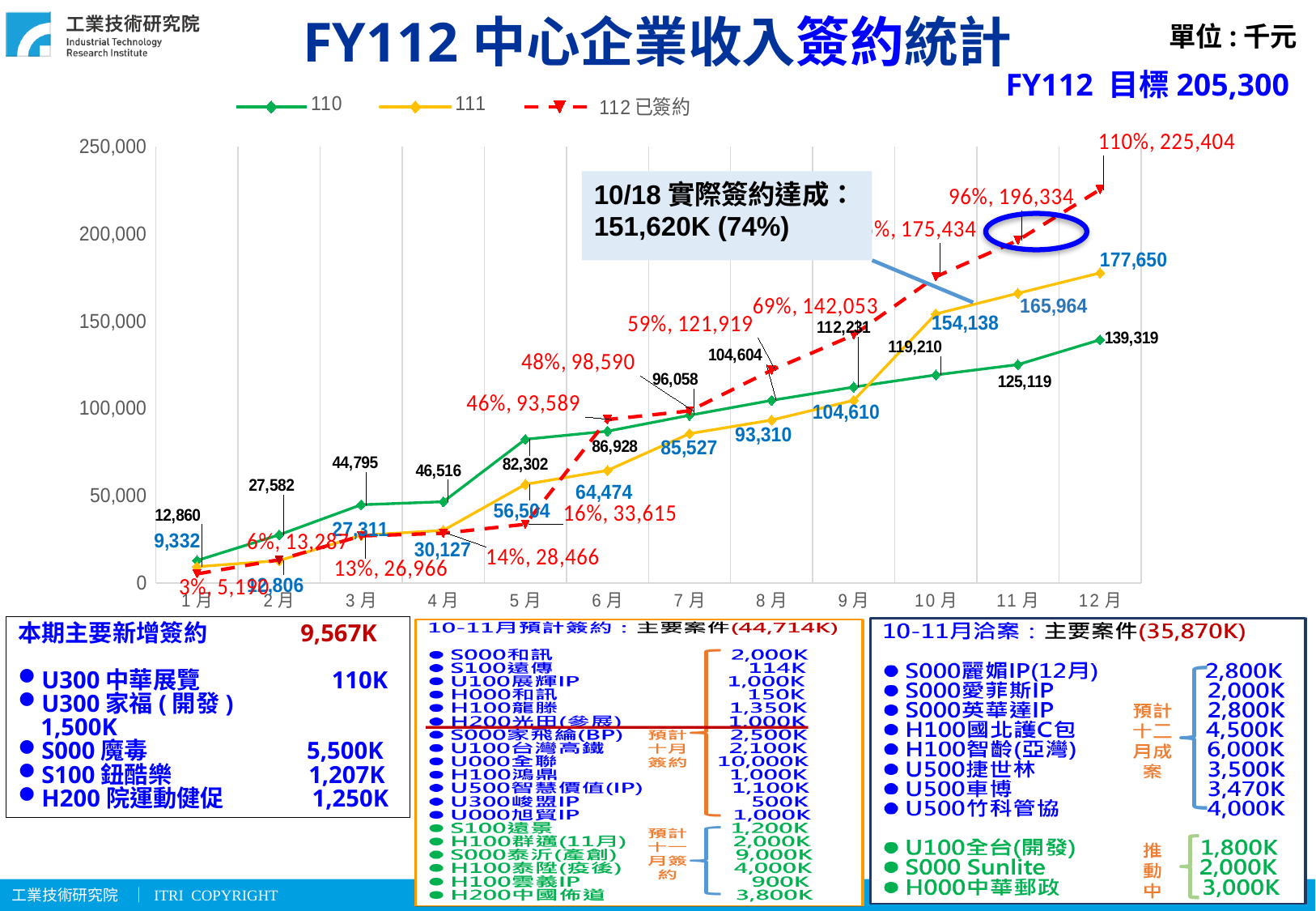
What is the value of the 111 series in 12月? 177,650 What is the value of the 110 series in 12月? 139,319 How many series does the chart legend list? 3 What kind of chart is shown on the slide? line chart What percentage is labelled for the 112 已簽約 series in 12月? 110% Is the value of the 110 series in 12月 greater or less than 150,000? less What is the value of the 110 series in 3月? 44,795 What is the value of the 111 series in 10月? 154,138 What FY112 target value is stated on the slide? 205,300 How many months are plotted along the x axis? 12 In 12月, which series has the larger value, 110 or 111? 111 What is the difference between the 111 and 110 series values in 12月? 38,331